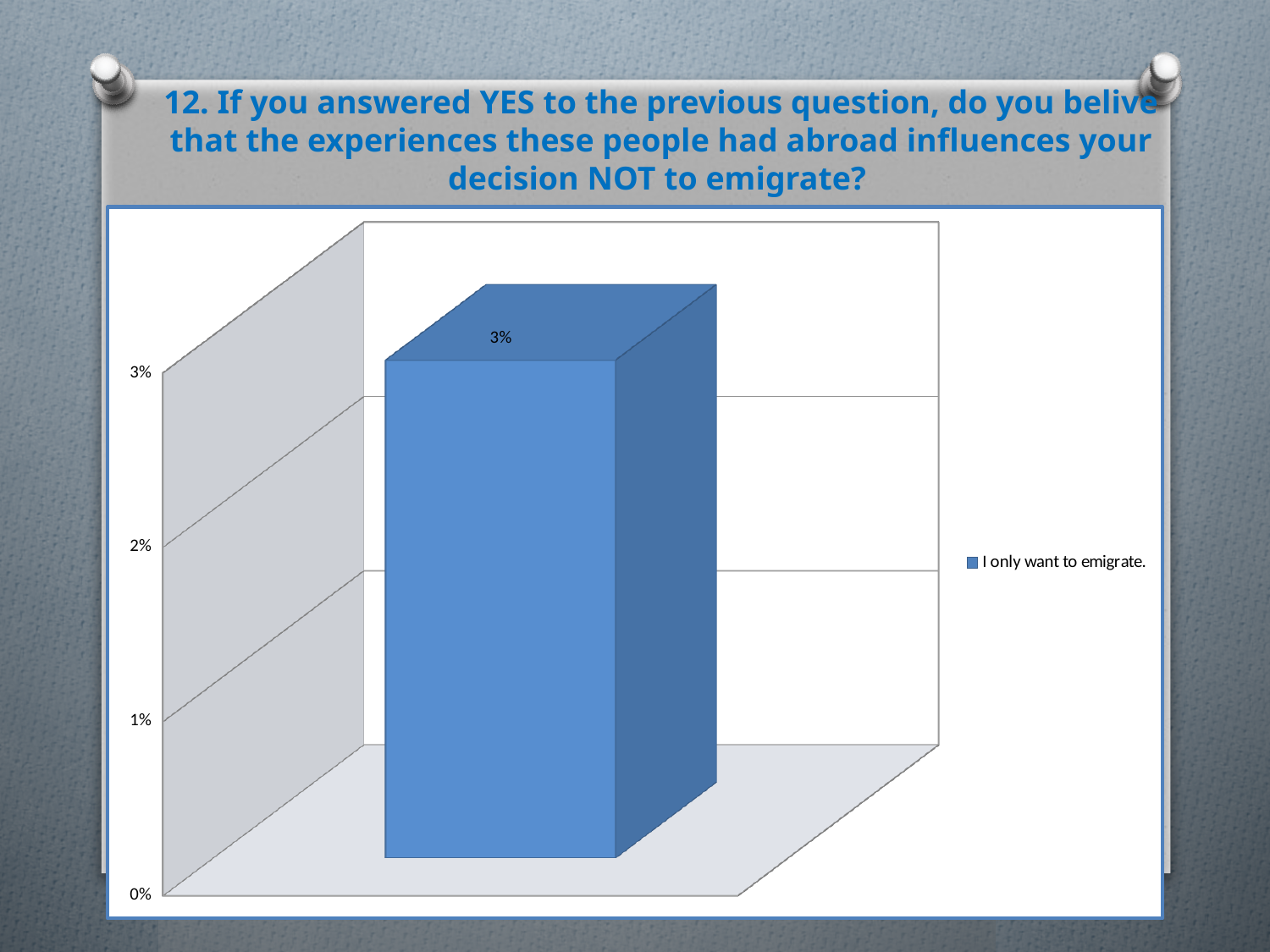
What value is shown for the series "I only want to emigrate."? 3% Is the value for "I only want to emigrate." greater or less than 2%? greater What kind of chart is shown on the slide? bar chart How many series does the legend list? 1 Is the value for "I only want to emigrate." greater or less than 1%? greater What is the highest value shown on the vertical axis? 3% How many bars are plotted in the chart? 1 What is the legend entry for the series shown in the chart? I only want to emigrate.